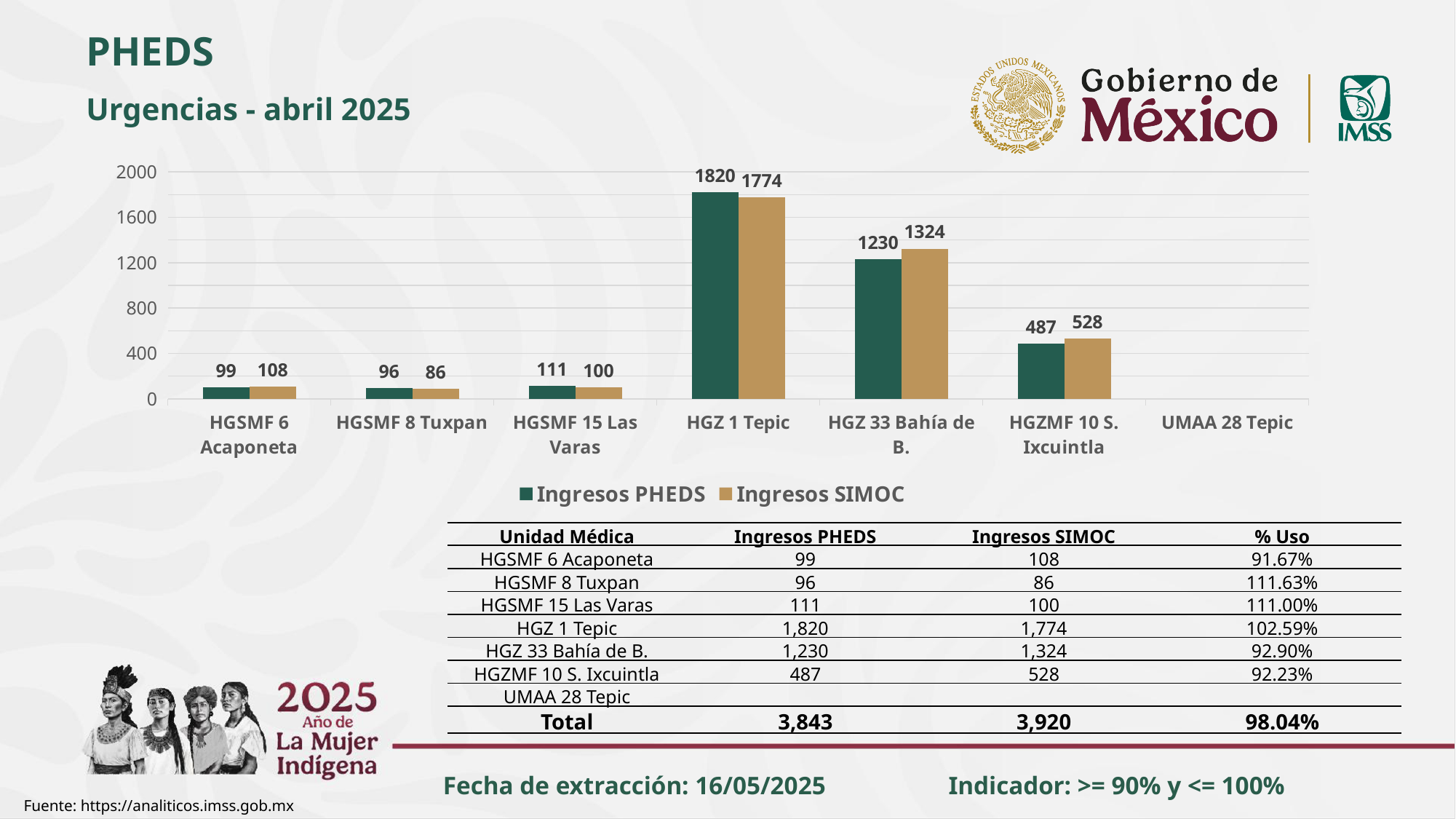
For HGZ 33 Bahía de B., which is larger: Ingresos PHEDS or Ingresos SIMOC? Ingresos SIMOC What is the Ingresos PHEDS value for HGZMF 10 S. Ixcuintla? 487 Which category has the lowest Ingresos SIMOC value among those with data labels? HGSMF 8 Tuxpan How many categories are shown on the x axis of the bar chart? 7 What kind of chart is shown on the slide? Bar chart What is the Ingresos SIMOC value for HGZ 33 Bahía de B. in the bar chart? 1324 What is the difference between the Ingresos PHEDS and Ingresos SIMOC values for HGZ 1 Tepic? 46 Is the Ingresos SIMOC value for HGZMF 10 S. Ixcuintla greater or less than 400? greater Which category has the highest Ingresos PHEDS value? HGZ 1 Tepic What is the Ingresos PHEDS value for HGZ 1 Tepic in the bar chart? 1820 How many series does the legend of the chart list? 2 Which category on the x axis has no bars plotted? UMAA 28 Tepic